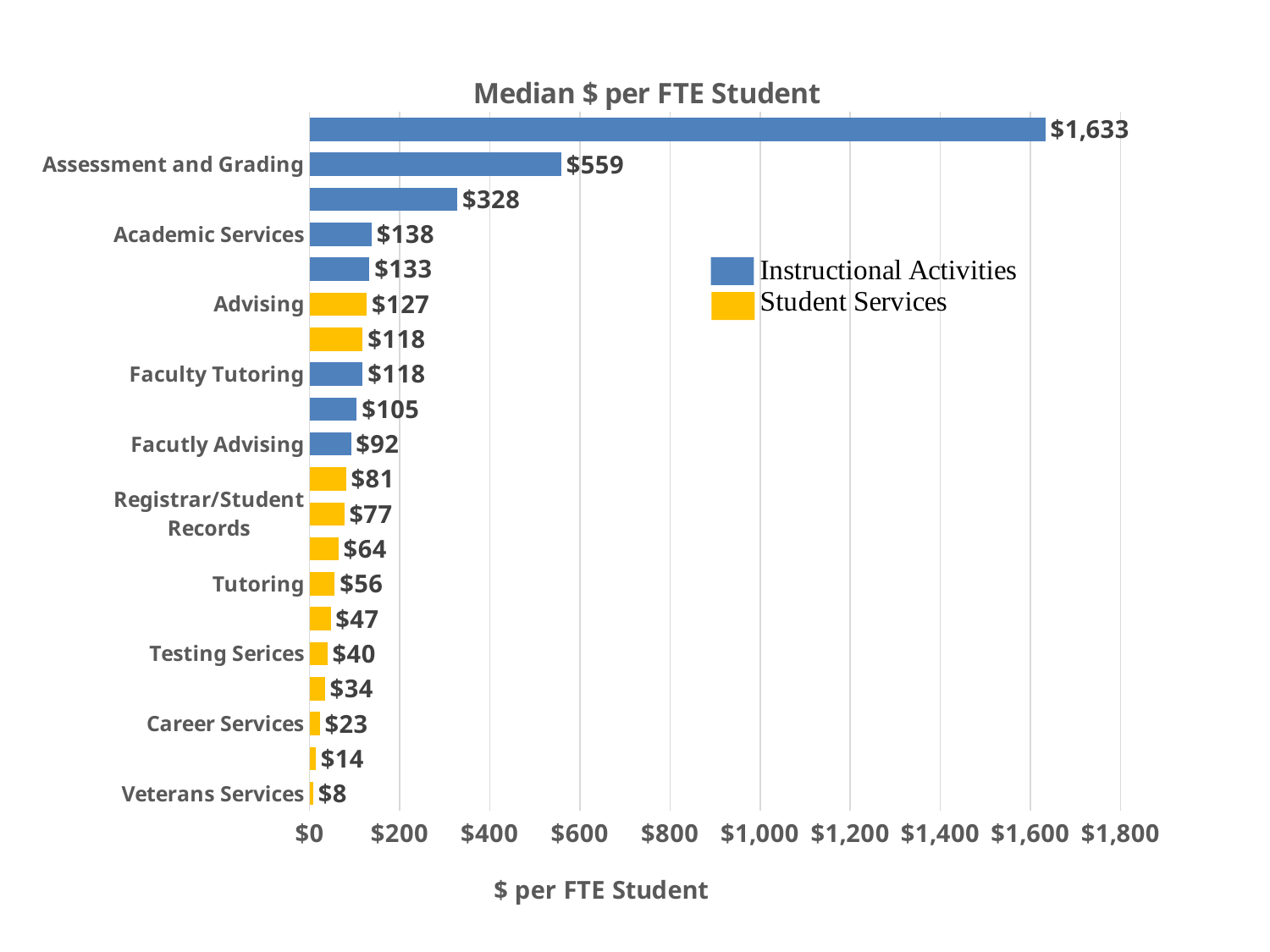
What is the value shown for Advising? $127 What is the value shown for Tutoring? $56 How many bars are plotted in the chart? 20 What kind of chart is shown on the slide? bar chart Which is larger, the value for Faculty Tutoring or the value for Facutly Advising? Faculty Tutoring What is the value shown for Career Services? $23 How many series does the legend list? 2 Is the value for Assessment and Grading greater or less than $400? greater What is the median $ per FTE student for Assessment and Grading? $559 Which labeled category has the lowest median $ per FTE student? Veterans Services What is the title of the chart? Median $ per FTE Student What is the difference between the values for Academic Services and Advising? $11